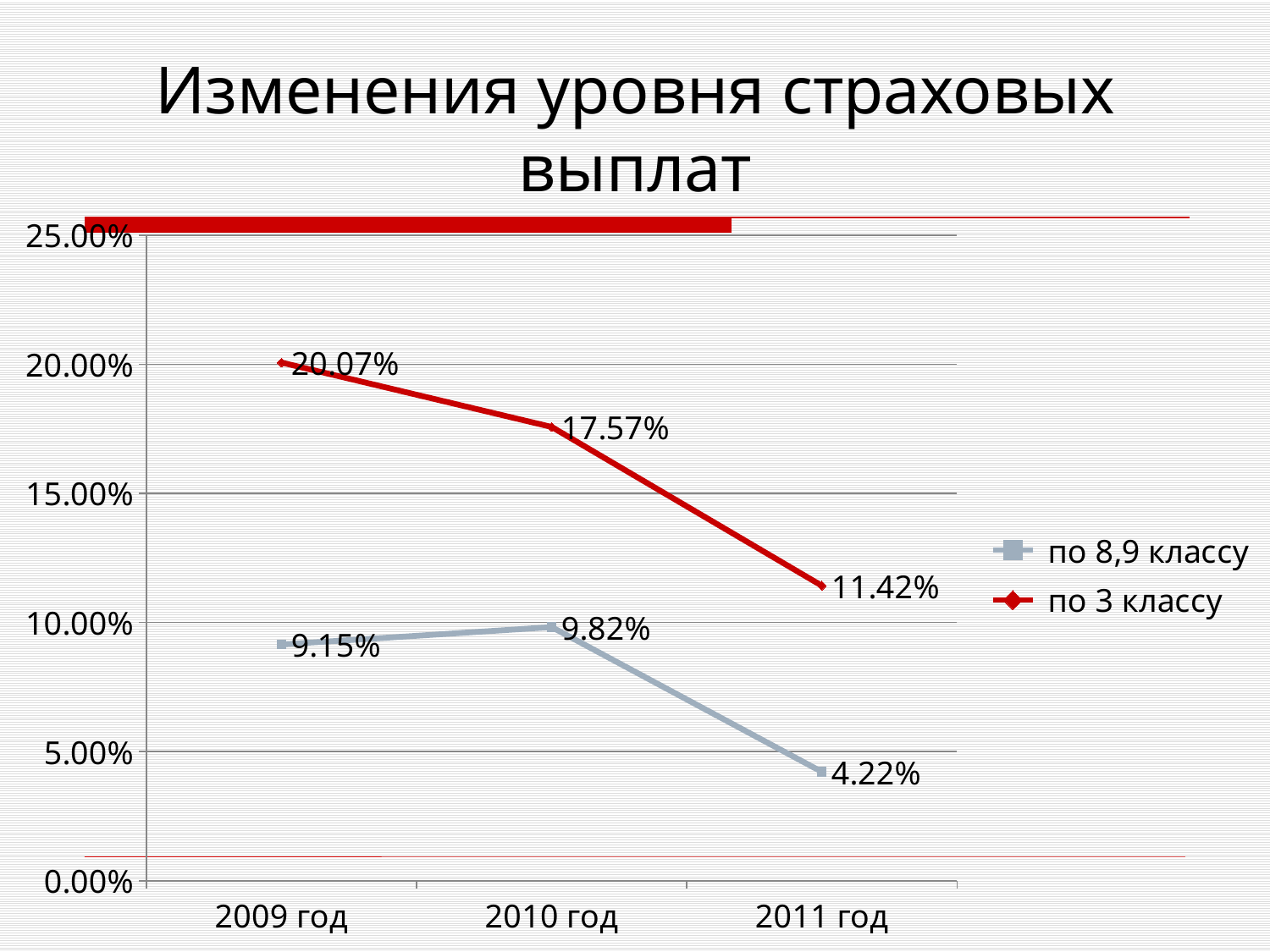
What is the value for "по 3 классу" in 2010 год? 17.57% What is the value for "по 8,9 классу" in 2011 год? 4.22% Does the "по 3 классу" series rise or fall from 2009 год to 2011 год? fall In which year is the value for "по 8,9 классу" highest? 2010 год Is the value for "по 3 классу" in 2011 год greater or less than 10.00%? greater How many years are shown on the x axis? 3 In which year is the value for "по 3 классу" lowest? 2011 год How many series does the legend list? 2 What is the difference between the "по 3 классу" and "по 8,9 классу" values in 2011 год? 7.20% Which series has the larger value in 2010 год, "по 3 классу" or "по 8,9 классу"? по 3 классу What kind of chart is shown on the slide? line chart What is the value for "по 3 классу" in 2009 год? 20.07%